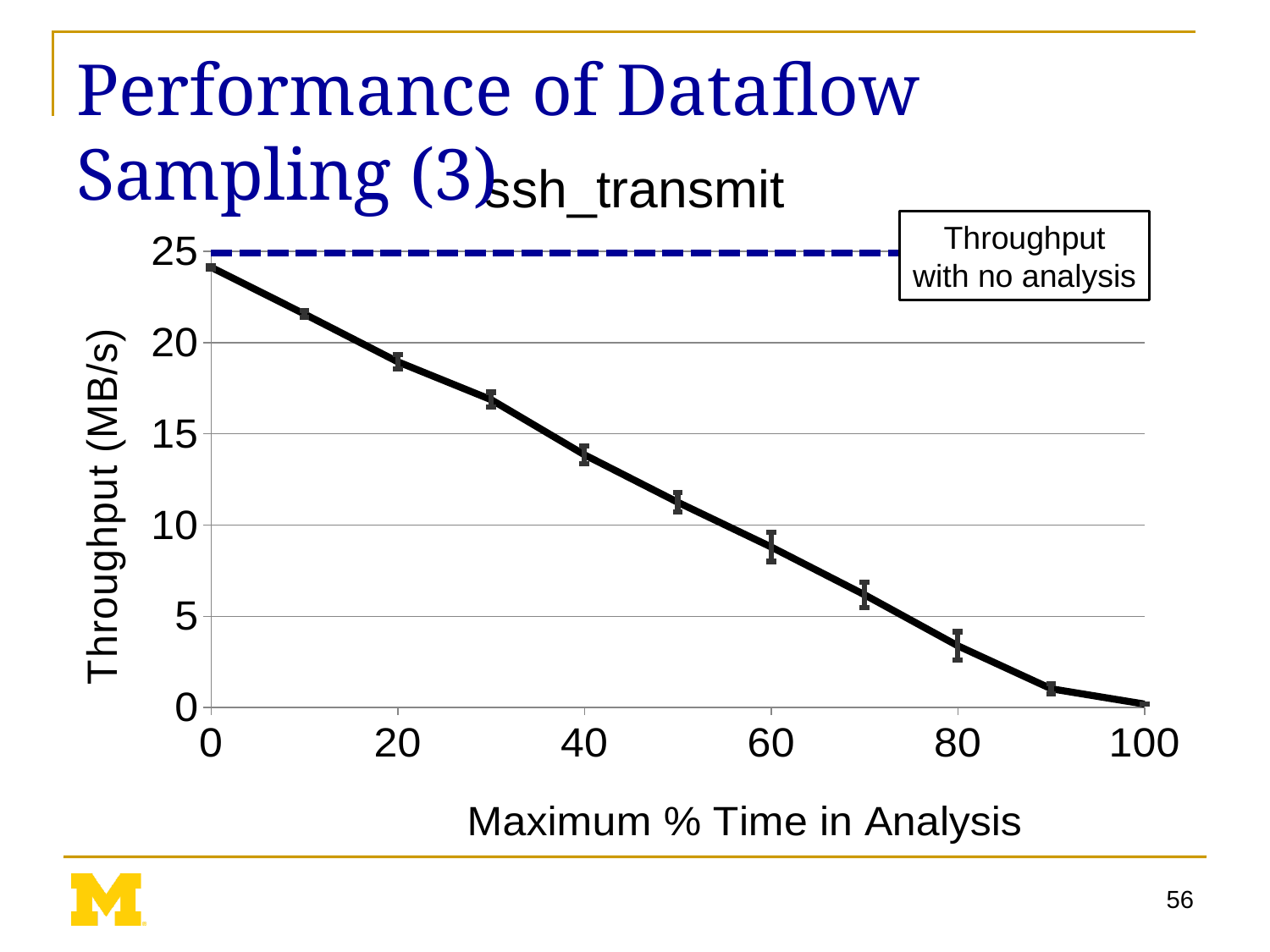
Is the throughput at 20% Maximum Time in Analysis greater or less than 15? greater What kind of chart is shown on the slide? line chart Which has higher throughput: 20% or 60% Maximum Time in Analysis? 20% Is the throughput at 0% Maximum Time in Analysis greater or less than 20? greater What is the label of the y axis? Throughput (MB/s) How many data points are plotted on the solid line? 11 At which Maximum % Time in Analysis value is throughput lowest? 100 Does throughput rise or fall as Maximum % Time in Analysis increases? fall Is the throughput at 80% Maximum Time in Analysis greater or less than 5? less What is the title of the chart? ssh_transmit At which Maximum % Time in Analysis value is throughput highest? 0